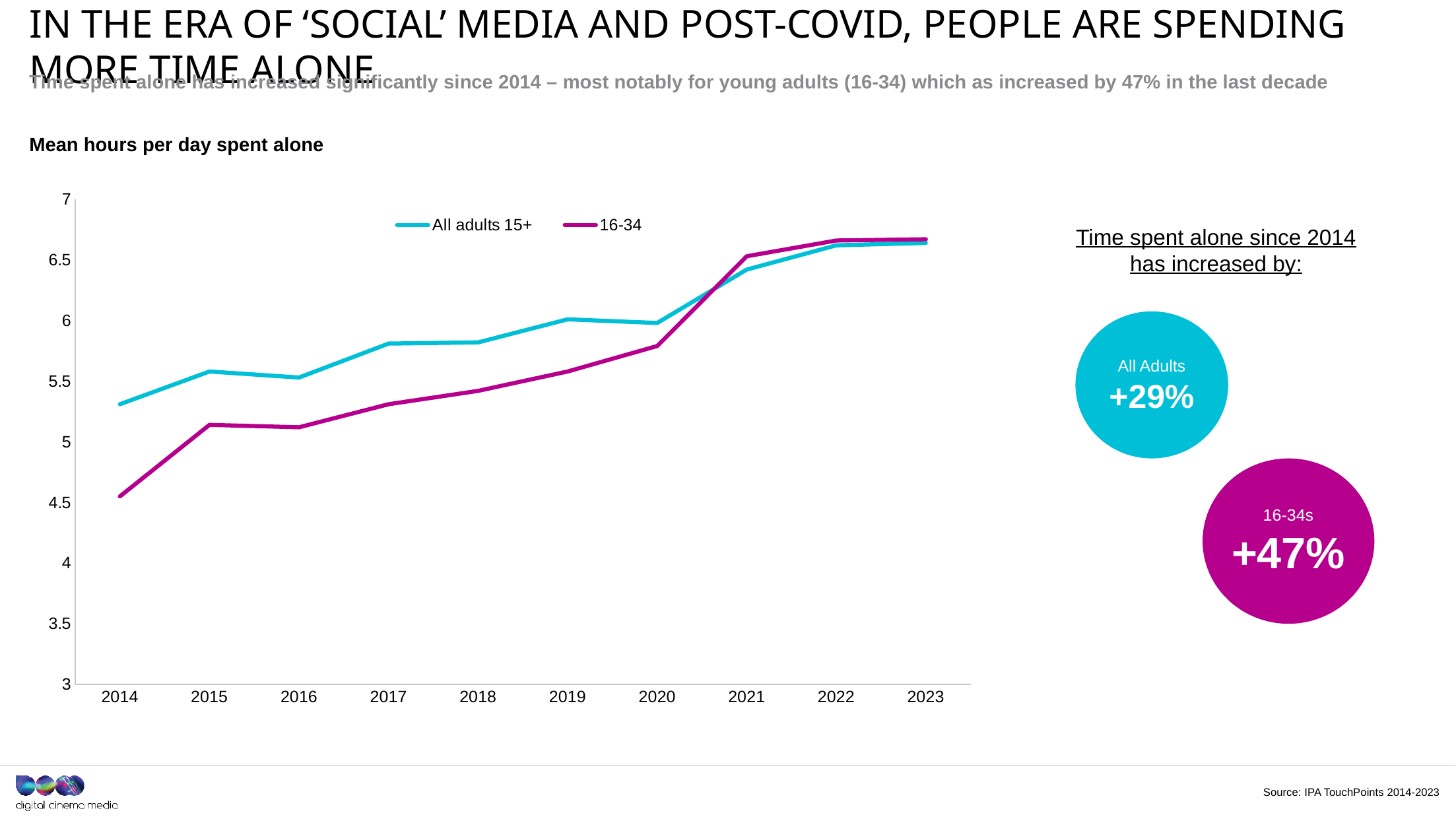
In which year is the 16-34 series at its lowest value? 2014 In 2014, which series has the higher value: All adults 15+ or 16-34? All adults 15+ How many series does the chart legend list? 2 Do the values for the 16-34 series generally rise or fall from 2014 to 2023? Rise Is the value for 16-34 in 2023 greater or less than 6.5? greater How many years are plotted along the x axis of the chart? 10 Is the value for 16-34 in 2020 greater or less than 6? less What is the title of the chart? Mean hours per day spent alone Is the value for All adults 15+ in 2014 greater or less than 5? greater Which series is drawn in the magenta/purple line? 16-34 What kind of chart is shown on the slide? Line chart